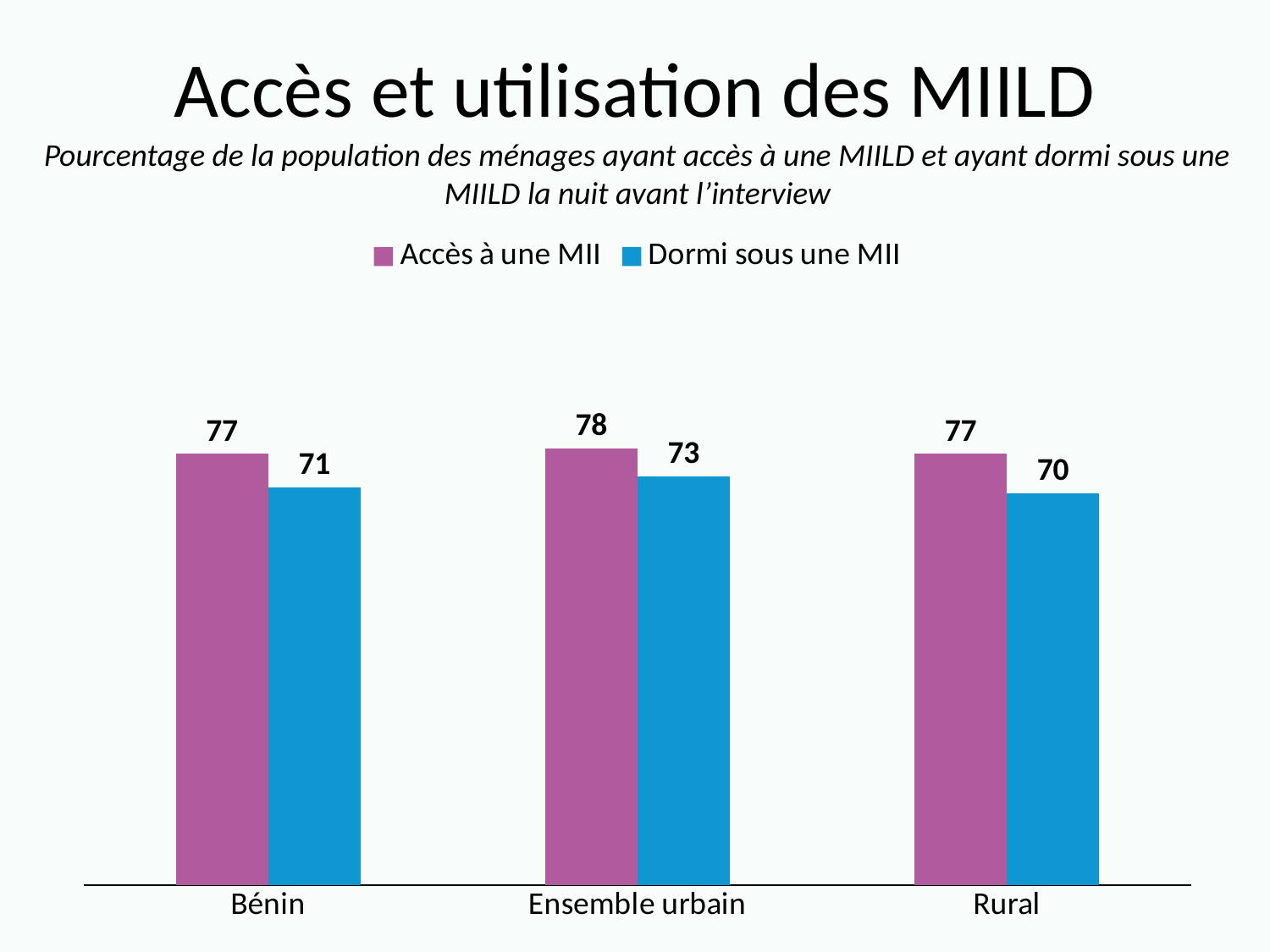
How many series does the legend list? 2 What kind of chart is shown on the slide? Bar chart What is the value for 'Dormi sous une MII' for Rural? 70 What is the difference between 'Dormi sous une MII' for Ensemble urbain and for Bénin? 2 What is the difference between 'Accès à une MII' and 'Dormi sous une MII' for Rural? 7 Which category has the lowest value for 'Dormi sous une MII'? Rural Which is larger for Bénin: 'Accès à une MII' or 'Dormi sous une MII'? Accès à une MII What is the value for 'Accès à une MII' for Bénin? 77 What is the value for 'Accès à une MII' for Ensemble urbain? 78 How many categories are shown on the x axis? 3 Which category has the highest value for 'Accès à une MII'? Ensemble urbain What is the value for 'Dormi sous une MII' for Ensemble urbain? 73